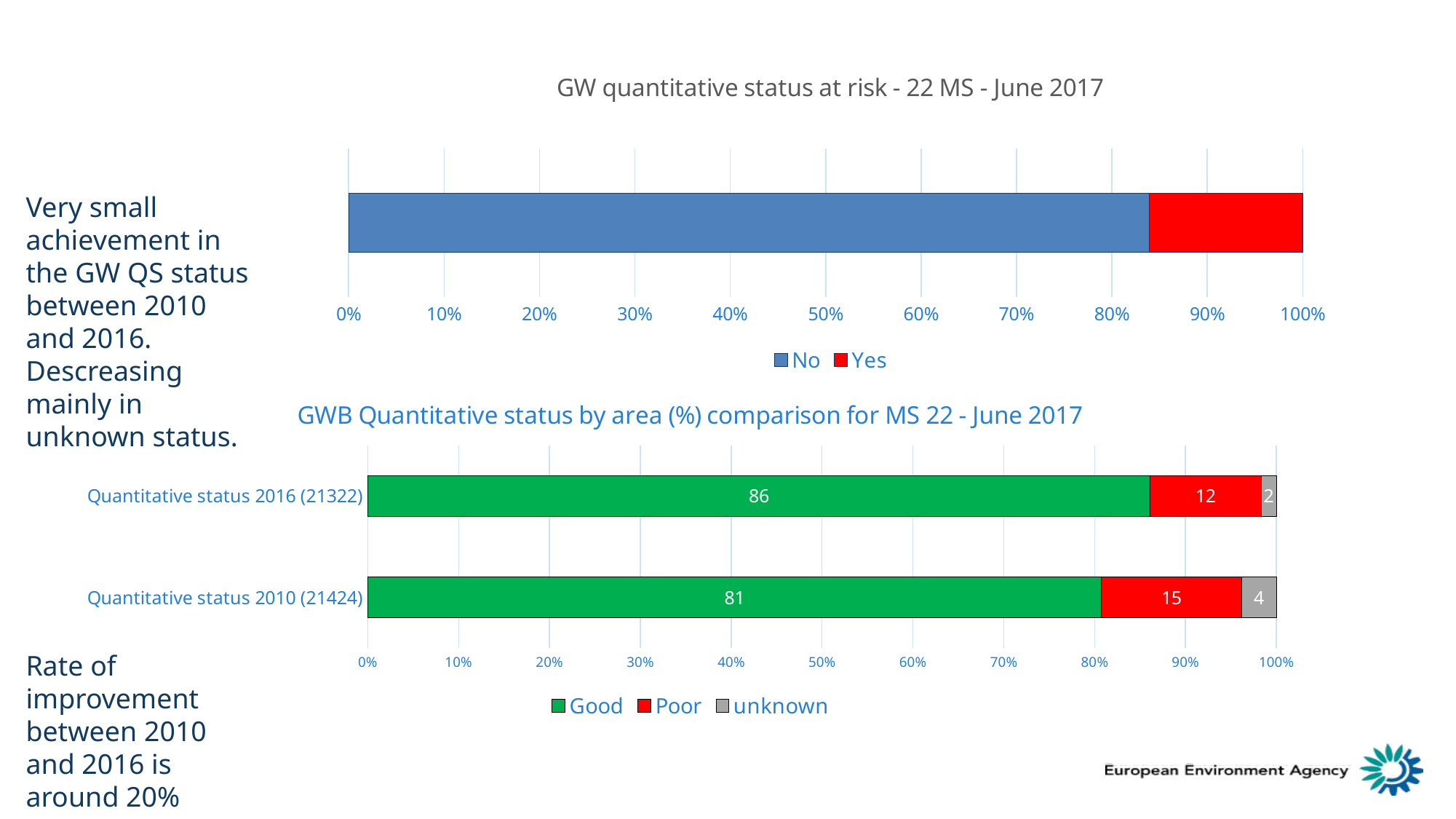
In the 'GWB Quantitative status by area (%) comparison' chart, what is the total of the stacked bar for Quantitative status 2010 (21424)? 100 In the 'GWB Quantitative status by area (%) comparison' chart, what is the unknown value for Quantitative status 2016 (21322)? 2 In the 'GWB Quantitative status by area (%) comparison' chart, what is the Poor value for Quantitative status 2010 (21424)? 15 In the 'GWB Quantitative status by area (%) comparison' chart, which year has the larger Poor value, 2010 or 2016? 2010 In the 'GW quantitative status at risk - 22 MS - June 2017' chart, which colour represents Yes? Red In the 'GWB Quantitative status by area (%) comparison' chart, what is the difference between the Good values for 2016 and 2010? 5 How many series does the legend of the 'GWB Quantitative status by area (%) comparison' chart list? 3 How many categories are shown in the 'GWB Quantitative status by area (%) comparison' chart? 2 In the 'GW quantitative status at risk - 22 MS - June 2017' chart, is the value for No greater or less than 80%? greater In the 'GWB Quantitative status by area (%) comparison' chart, what is the Good value for Quantitative status 2016 (21322)? 86 In the 'GW quantitative status at risk - 22 MS - June 2017' chart, is the value for Yes greater or less than 20%? less What kind of chart is the 'GW quantitative status at risk - 22 MS - June 2017' chart? Stacked bar chart